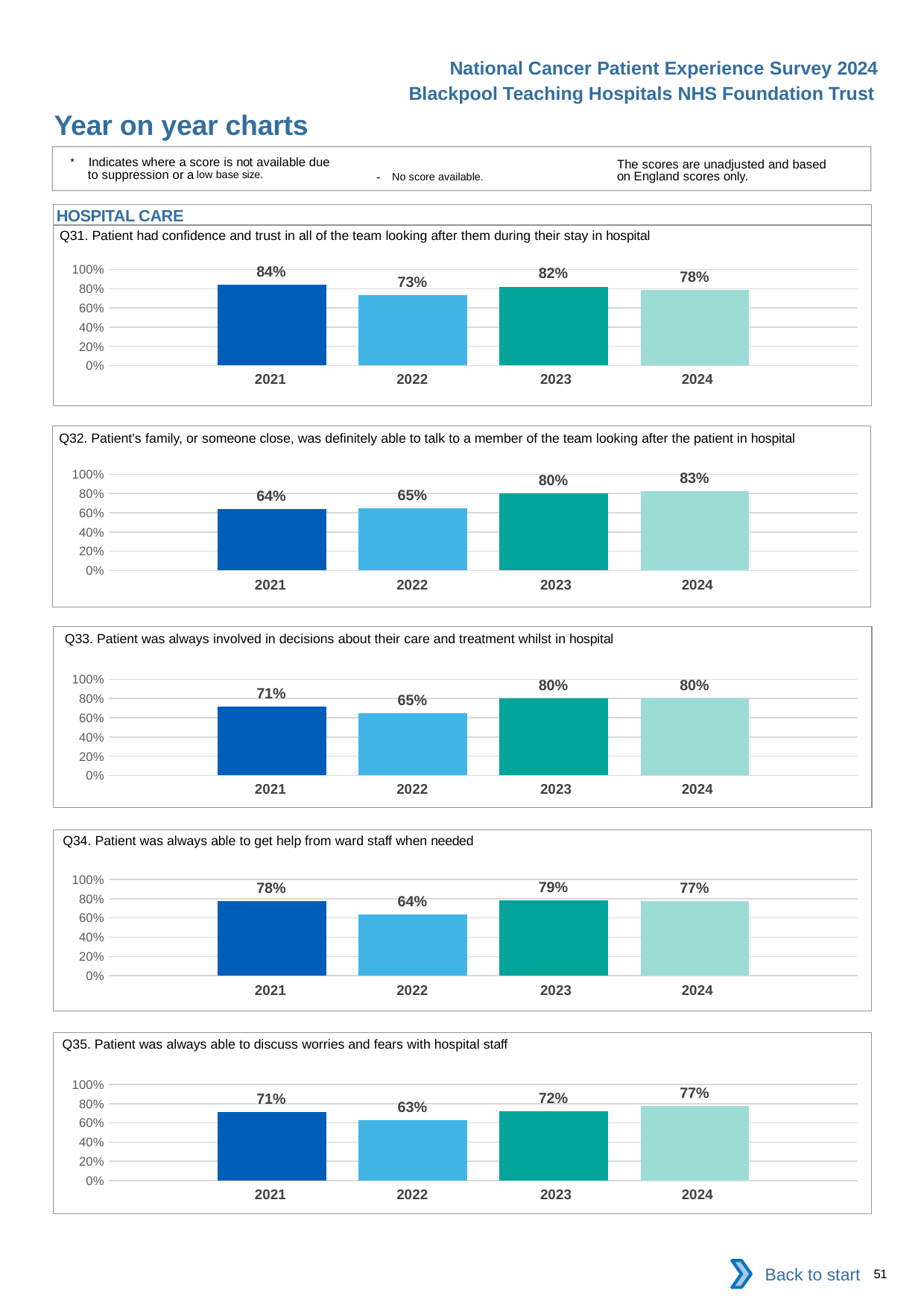
In the Q32 chart (family able to talk to a member of the team), do the values rise or fall from 2021 to 2024? rise What type of chart is used for Q31 (confidence and trust in the team)? bar chart In the Q31 chart (confidence and trust in the team), which year has the lowest value? 2022 In the Q34 chart (able to get help from ward staff), what is the difference between the 2021 and 2022 values? 14 percentage points In the Q35 chart (discuss worries and fears with hospital staff), what is the value for 2024? 77% In the Q32 chart (family able to talk to a member of the team), what is the value for 2024? 83% In the Q33 chart (involved in decisions about care), which is larger, the 2021 value or the 2022 value? 2021 In the Q33 chart (involved in decisions about care), what is the value for 2022? 65% In the Q35 chart (discuss worries and fears with hospital staff), how many years are plotted? 4 In the Q31 chart (confidence and trust in the team), what is the value for 2021? 84% In the Q32 chart (family able to talk to a member of the team), what is the difference between the 2024 and 2021 values? 19 percentage points In the Q34 chart (able to get help from ward staff), which year has the highest value? 2023